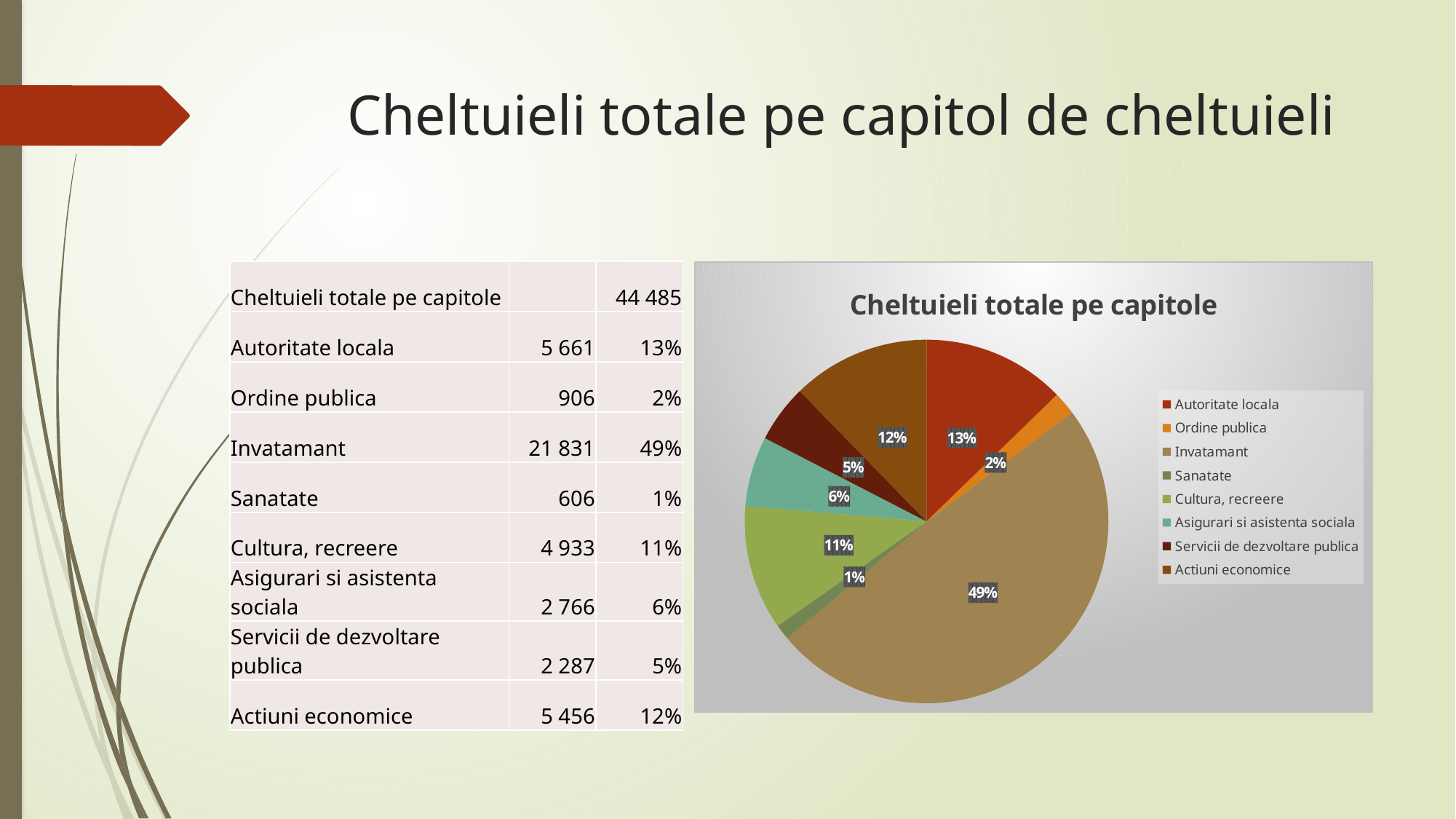
What is the difference in percentage points between the Invatamant slice and the Autoritate locala slice? 36% What share of the pie does Actiuni economice represent? 12% What kind of chart is shown on the slide? pie chart What share of the pie does Autoritate locala represent? 13% What share of the pie does Cultura, recreere represent? 11% How many categories does the pie chart legend list? 8 Which category has the smallest slice of the pie? Sanatate Which category has the largest slice of the pie? Invatamant Which slice is larger, Asigurari si asistenta sociala or Ordine publica? Asigurari si asistenta sociala What is the title of the chart? Cheltuieli totale pe capitole